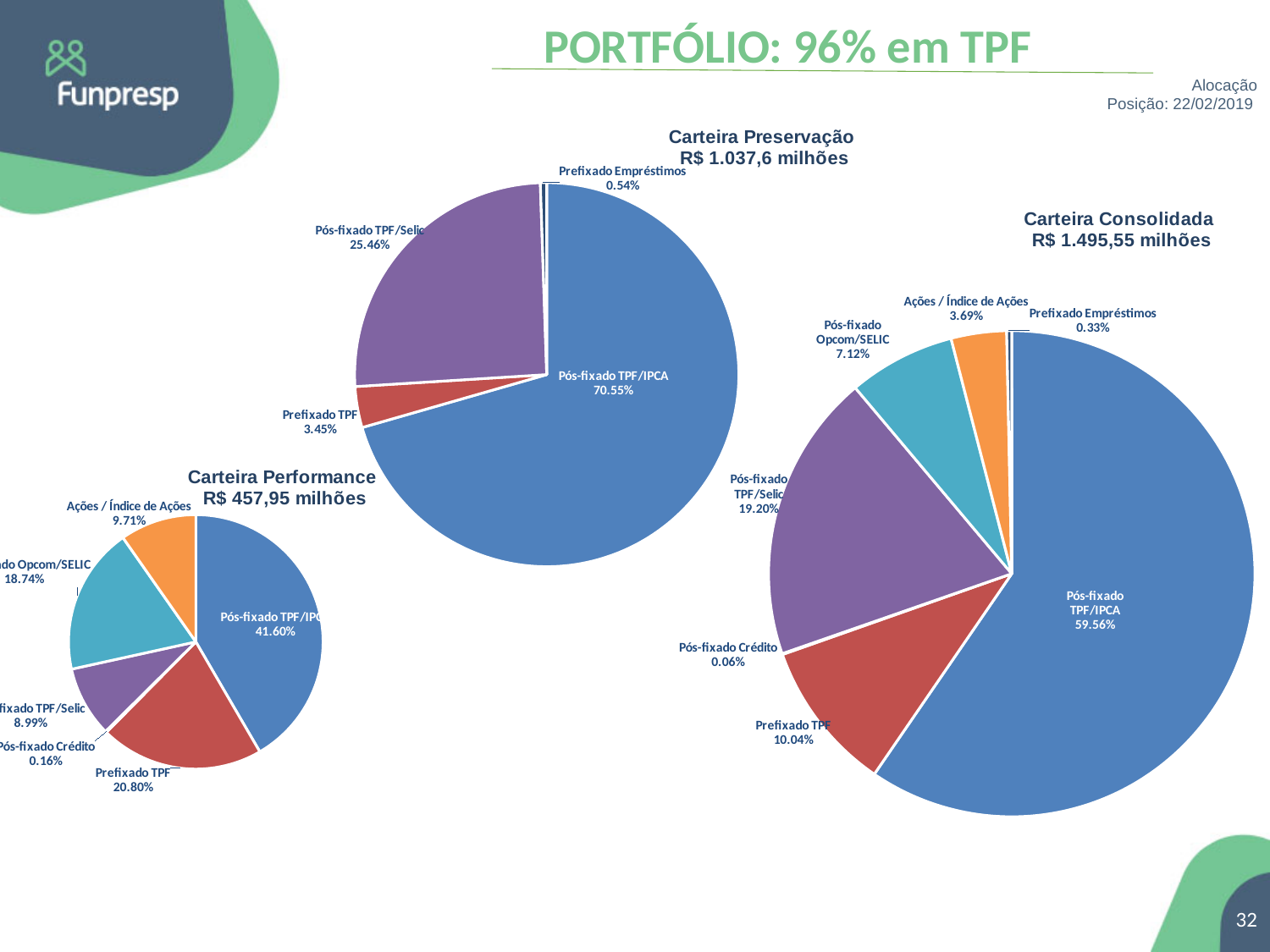
In the Carteira Consolidada chart, what is the value for Prefixado Empréstimos? 0.33% How many slices does the Carteira Preservação chart have? 4 In the Carteira Performance chart, what is the difference between Pós-fixado TPF/IPCA and Prefixado TPF? 20.80% In the Carteira Consolidada chart, what share does Pós-fixado TPF/IPCA have? 59.56% How many slices does the Carteira Consolidada chart have? 7 In the Carteira Consolidada chart, which is larger: Pós-fixado TPF/Selic or Prefixado TPF? Pós-fixado TPF/Selic In the Carteira Consolidada chart, which category has the smallest share? Pós-fixado Crédito In the Carteira Preservação chart, which category has the largest share? Pós-fixado TPF/IPCA What total value is shown in the title of the Carteira Consolidada chart? R$ 1.495,55 milhões In the Carteira Preservação chart, what is the value for Pós-fixado TPF/Selic? 25.46% In the Carteira Performance chart, what is the value for Prefixado TPF? 20.80% What type of chart is used for Carteira Performance? Pie chart